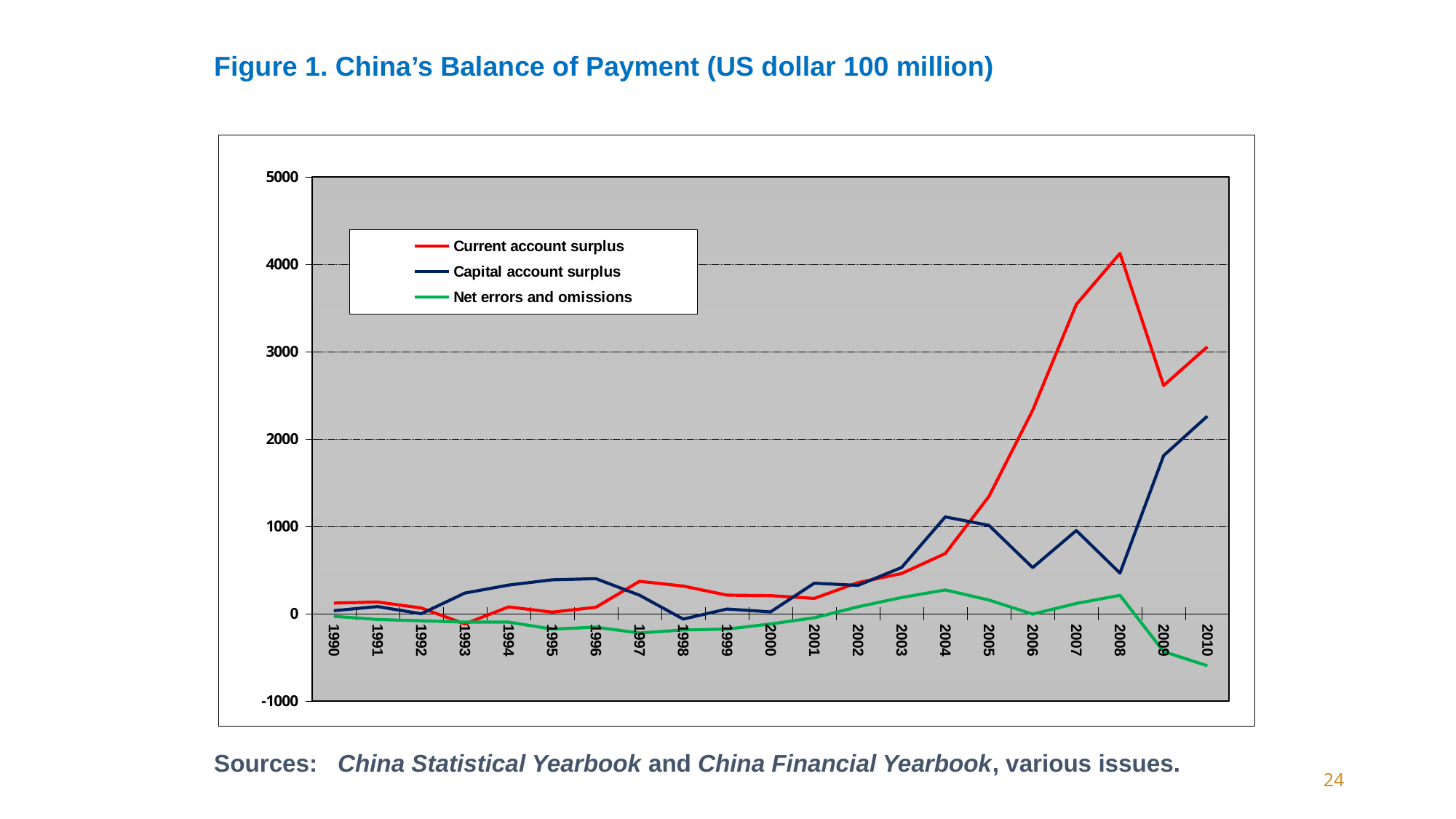
What colour is the line for Net errors and omissions? Green In 2006, which is larger: the Current account surplus or the Capital account surplus? Current account surplus In which year is Net errors and omissions at its lowest value? 2010 Is the Current account surplus in 2008 greater or less than 4000? greater In which year does the Current account surplus reach its highest value? 2008 What kind of chart is shown on the slide? Line chart Does the Current account surplus rise or fall between 2005 and 2008? Rise How many years are plotted along the x axis? 21 Is the Capital account surplus in 2010 greater or less than 2000? greater In which year does the Capital account surplus reach its highest value? 2010 How many series does the legend list? 3 Is the value of Net errors and omissions in 2010 greater or less than 0? less